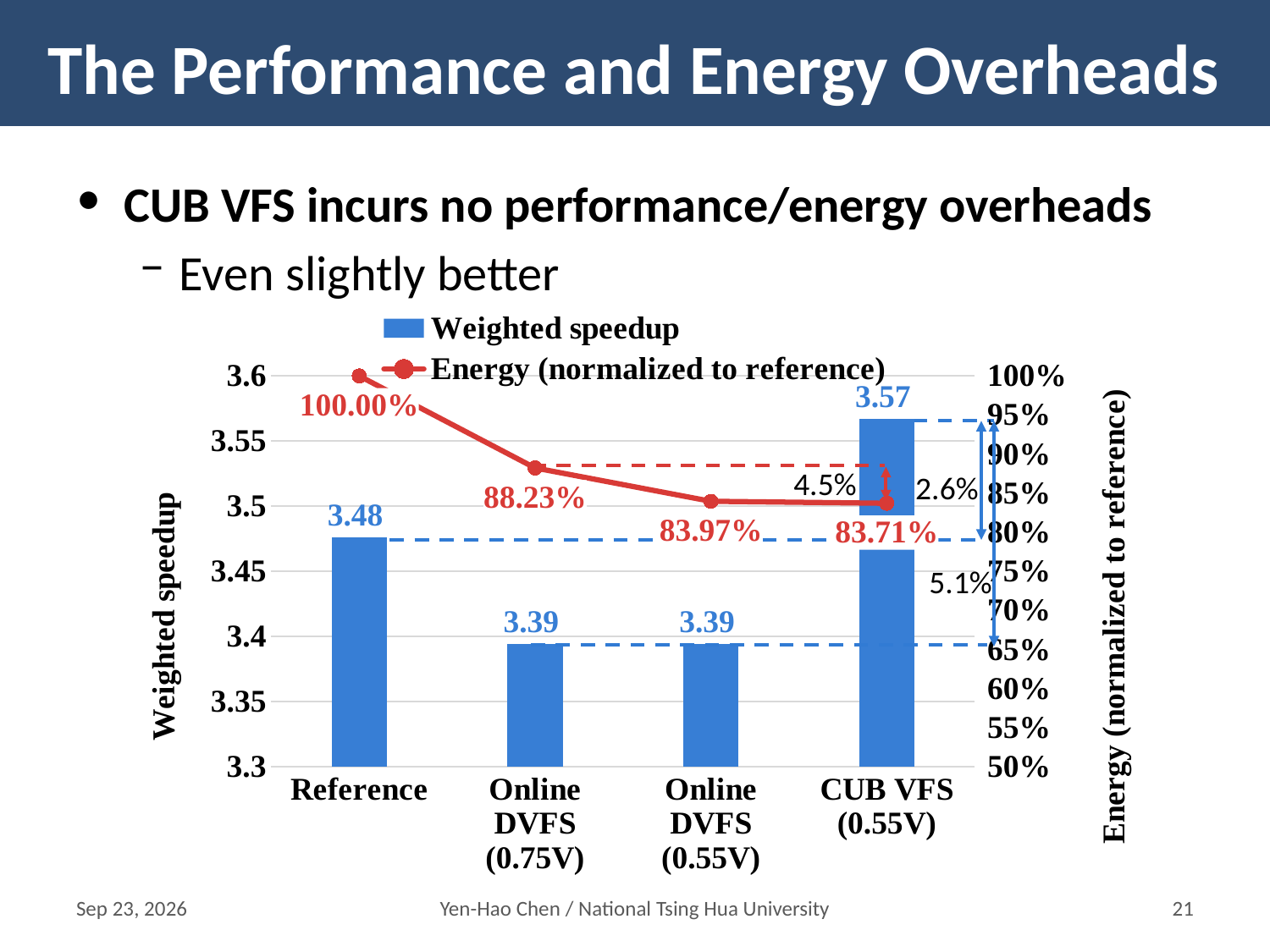
Which category has the highest weighted speedup? CUB VFS (0.55V) What is the difference in energy (normalized to reference) between Reference and Online DVFS (0.75V)? 11.77% Which category has the highest energy (normalized to reference)? Reference What is the energy (normalized to reference) for CUB VFS (0.55V)? 83.71% How many categories are shown on the x axis? 4 Does the energy (normalized to reference) rise or fall from Reference to CUB VFS (0.55V)? fall How many series does the legend list? 2 What is the weighted speedup for CUB VFS (0.55V)? 3.57 Which has a higher weighted speedup, Reference or Online DVFS (0.55V)? Reference What is the difference in weighted speedup between CUB VFS (0.55V) and Reference? 0.09 What is the weighted speedup for Reference? 3.48 What is the energy (normalized to reference) for Online DVFS (0.75V)? 88.23%